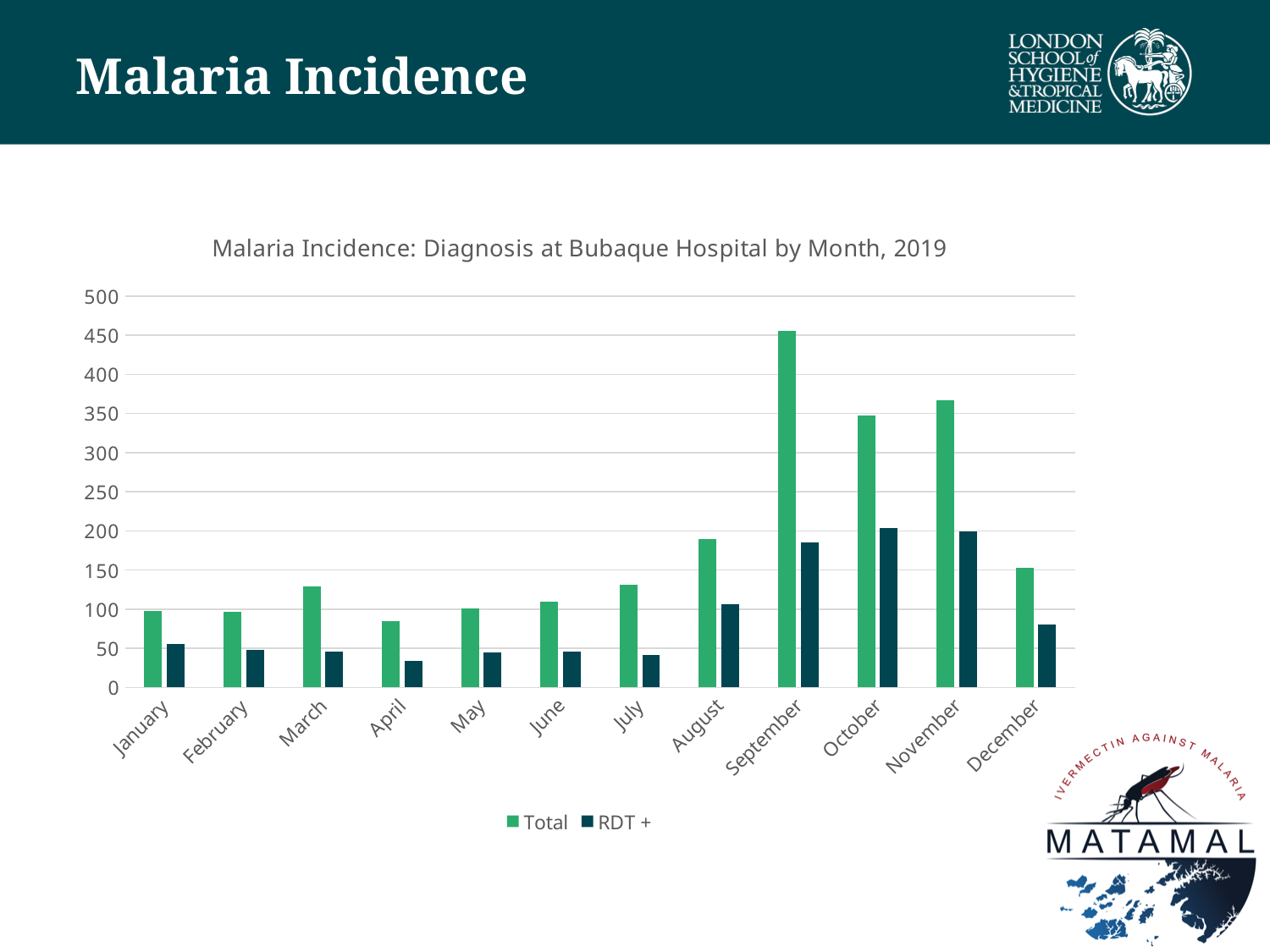
Is the Total value for September greater or less than 400? greater What kind of chart is shown on the slide? bar chart How many months are shown on the x axis? 12 Is the RDT + value for December greater or less than 50? greater Is the Total value for October greater or less than 300? greater What is the title of the chart? Malaria Incidence: Diagnosis at Bubaque Hospital by Month, 2019 Which month has the lowest Total value? April Which month has the highest Total value? September Do the Total values rise or fall from July to September? rise How many series does the legend list? 2 Which is larger, the Total value for August or the Total value for December? August Which month has the lowest RDT + value? April